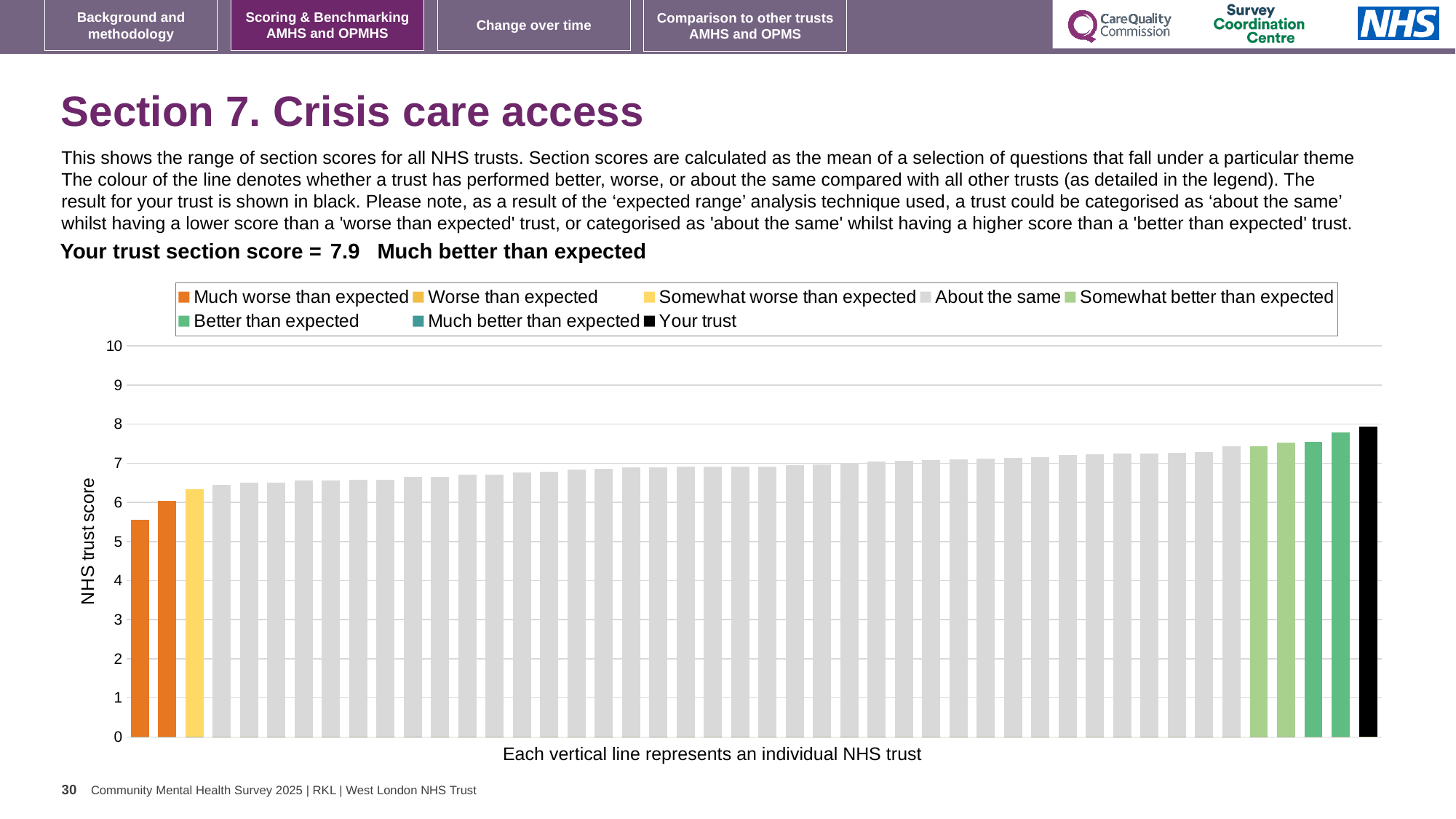
How many entries does the chart legend list? 8 Which bar is the highest on the chart? Your trust What is the section score for your trust? 7.9 What kind of chart is shown on the slide? bar chart What is the label below the horizontal axis? Each vertical line represents an individual NHS trust Is the value of the black 'Your trust' bar greater or less than 7? greater How many bars are coloured as 'Much worse than expected'? 2 What is the label on the vertical axis? NHS trust score Do the bar values rise or fall from left to right along the x axis? rise Which legend category is your trust's section score placed in? Much better than expected Is the value of the leftmost bar greater or less than 6? less Which legend category does the lowest bar belong to? Much worse than expected